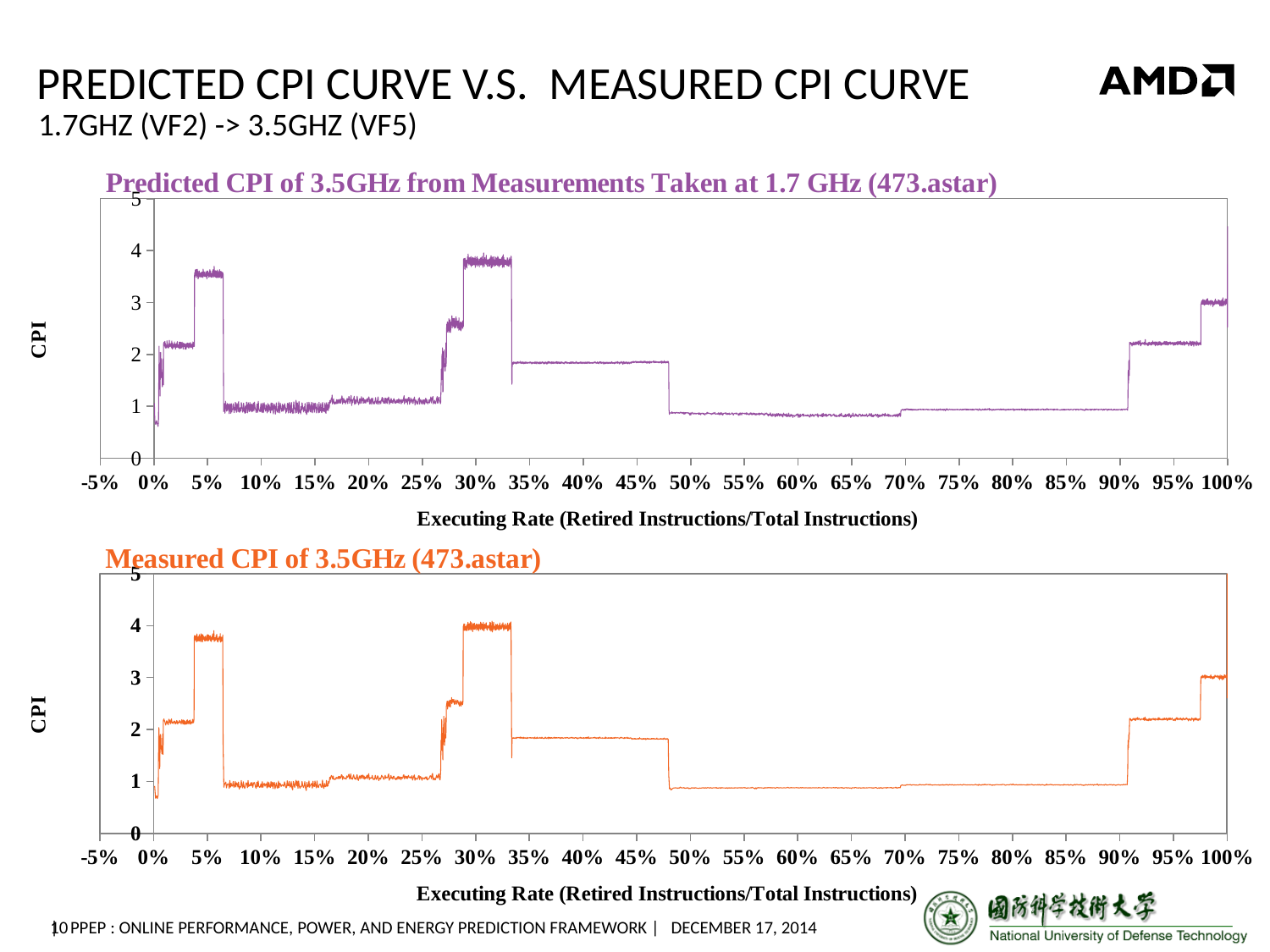
In the top chart (Predicted CPI), what is the label of the x axis? Executing Rate (Retired Instructions/Total Instructions) In the top chart (Predicted CPI), is the CPI value at an executing rate of 40% greater or less than 2? less What is the title of the bottom chart on the slide? Measured CPI of 3.5GHz (473.astar) In the bottom chart (Measured CPI), is the CPI value at an executing rate of 60% greater or less than 1? less In the top chart (Predicted CPI), is the CPI value at an executing rate of 60% greater or less than 1? less In the top chart (Predicted CPI), which has the larger CPI value: the executing rate of 10% or the executing rate of 95%? 95% In the bottom chart (Measured CPI), which has the larger CPI value: the executing rate of 30% or the executing rate of 60%? 30% What kind of chart is the top chart, 'Predicted CPI of 3.5GHz from Measurements Taken at 1.7 GHz (473.astar)'? line chart